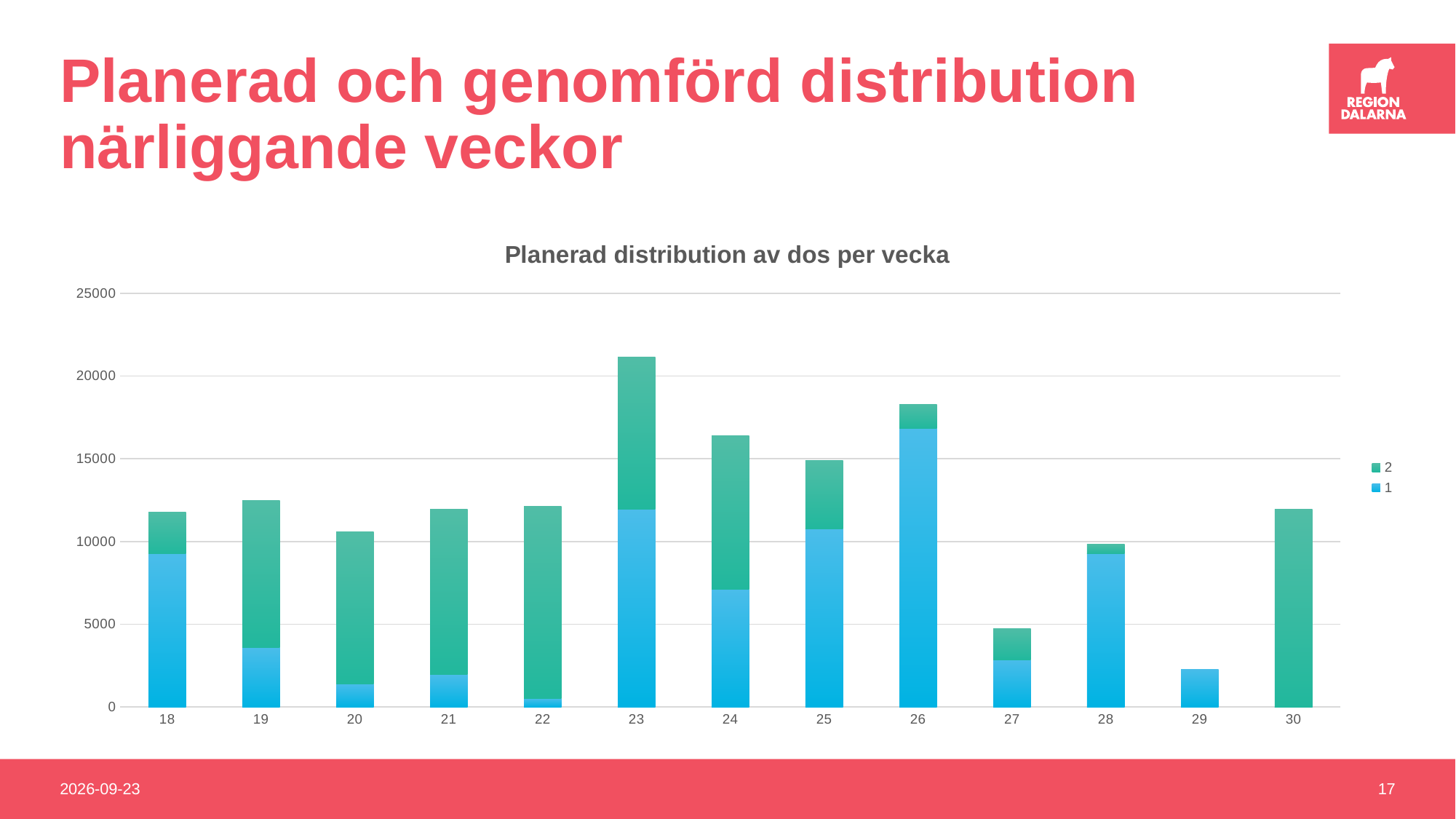
What kind of chart is shown on the slide? Stacked bar chart What is the title of the chart? Planerad distribution av dos per vecka Which week has a larger total, week 24 or week 25? 24 Which week has the largest value for series 1? 26 Which week's bar consists only of series 2 (no series 1 segment)? 30 Is the total for week 29 greater or less than 5000? less How many weeks (categories) are shown on the x axis? 13 Is the total for week 23 greater or less than 20000? greater How many series does the legend list? 2 Is the total for week 26 greater or less than 15000? greater Which week has the lowest total planned distribution? 29 Which week has the highest total planned distribution? 23